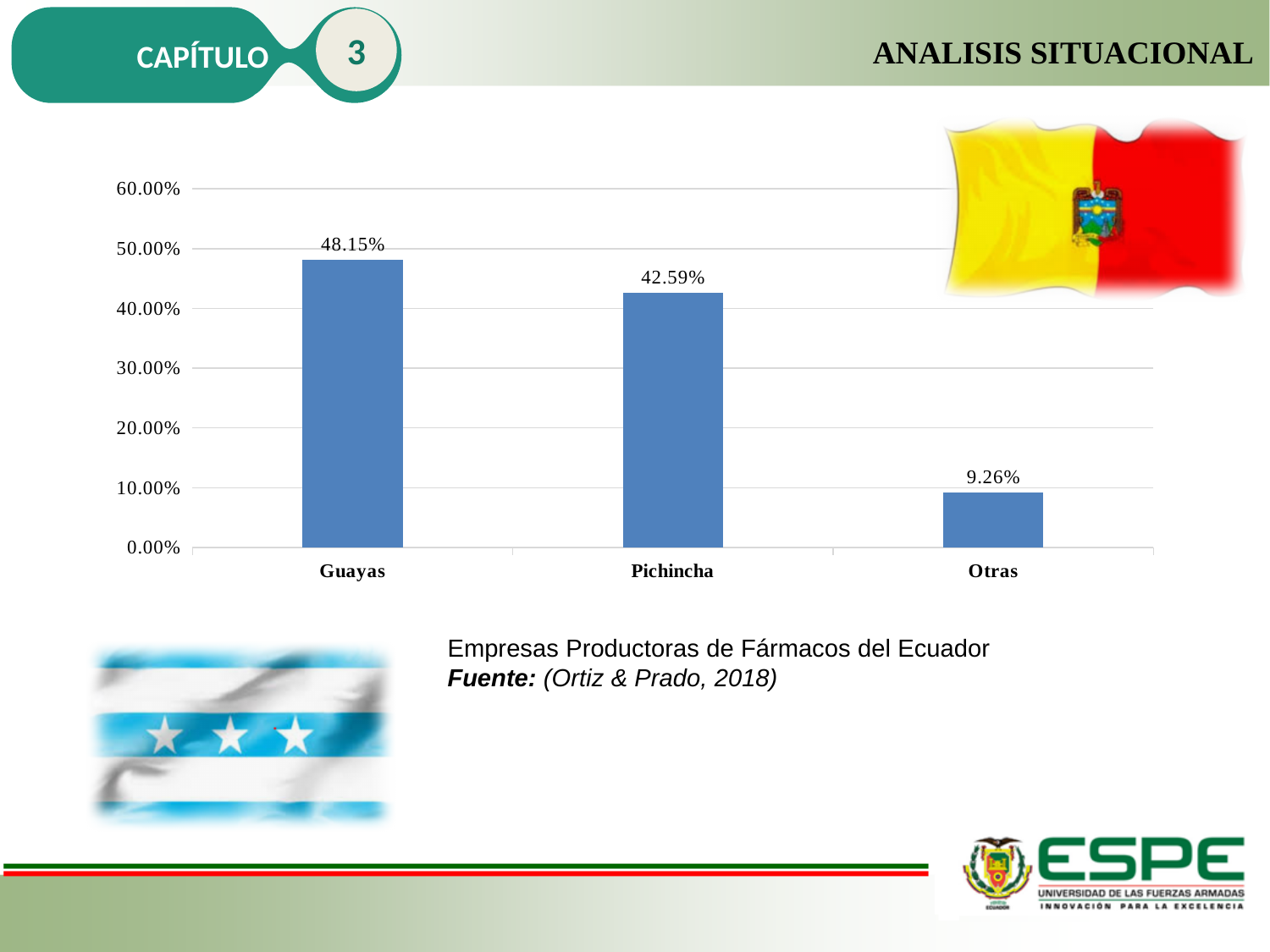
What kind of chart is shown on the slide? bar chart What is the value for Guayas? 48.15% What is the value for Pichincha? 42.59% Which category has the highest value? Guayas Do the values rise or fall from left to right across the categories? fall How many categories are shown on the chart? 3 Which category has the lowest value? Otras What is the difference between the values for Guayas and Pichincha? 5.56% Which is larger, the value for Guayas or the value for Pichincha? Guayas What is the difference between the values for Pichincha and Otras? 33.33% What is the value for Otras? 9.26% Is the value for Otras greater or less than 10.00%? less